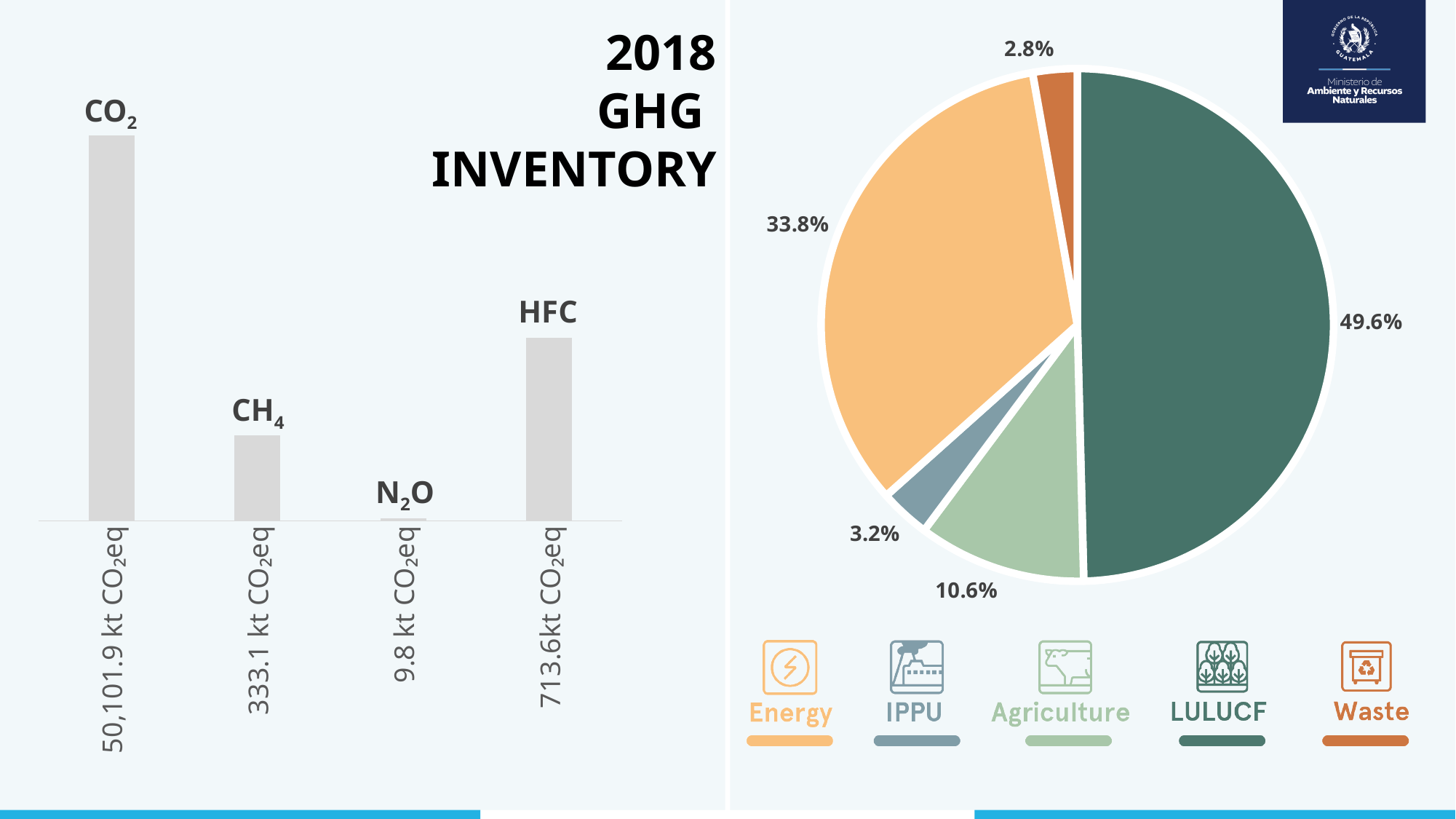
On the pie chart on the right, which sector has the smallest share? Waste On the pie chart on the right, what share does IPPU have? 3.2% On the pie chart on the right, what is the difference between the Energy share and the Agriculture share? 23.2% On the bar chart on the left, which gas has the highest value? CO2 How many gases are shown on the bar chart on the left? 4 On the bar chart on the left, what is the value for CO2? 50,101.9 kt CO2eq On the bar chart on the left, what is the value for N2O? 9.8 kt CO2eq On the pie chart on the right, what share does LULUCF have? 49.6% On the bar chart on the left, which is larger, CH4 or HFC? HFC On the bar chart on the left, which gas has the lowest value? N2O On the bar chart on the left, what is the value for HFC? 713.6 kt CO2eq What type of chart is on the right side of the slide? Pie chart